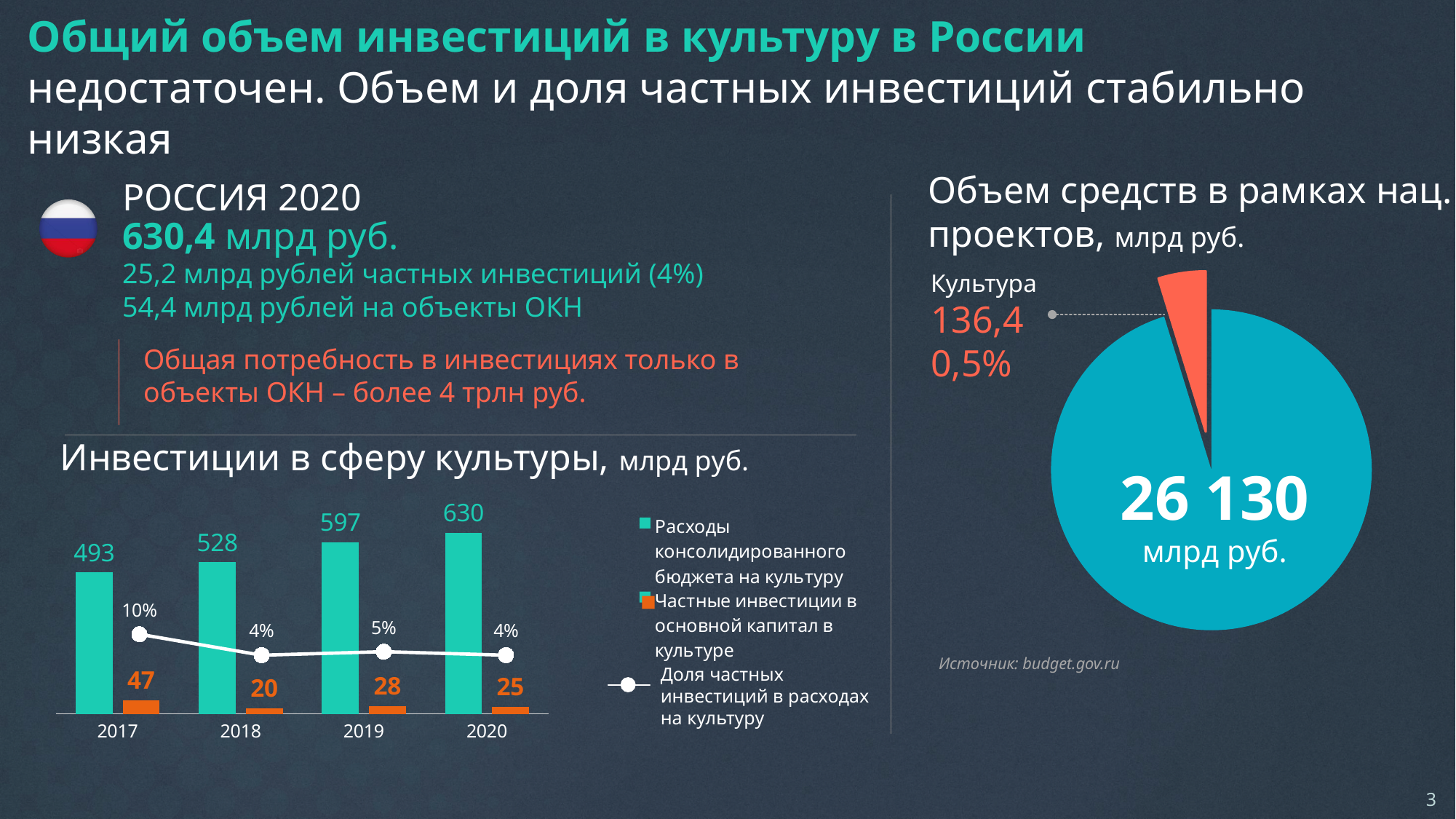
In the chart 'Инвестиции в сферу культуры, млрд руб.', which year has the highest value for 'Расходы консолидированного бюджета на культуру'? 2020 In the pie chart 'Объем средств в рамках нац. проектов, млрд руб.', what is the value shown for 'Культура'? 136,4 How many series does the legend of the chart 'Инвестиции в сферу культуры, млрд руб.' list? 3 In the chart 'Инвестиции в сферу культуры, млрд руб.', what is the 'Доля частных инвестиций в расходах на культуру' for 2017? 10% How many years are shown on the x axis of the chart 'Инвестиции в сферу культуры, млрд руб.'? 4 In the pie chart 'Объем средств в рамках нац. проектов, млрд руб.', what share does the 'Культура' slice represent? 0,5% In the chart 'Инвестиции в сферу культуры, млрд руб.', do the values for 'Расходы консолидированного бюджета на культуру' rise or fall from 2017 to 2020? rise In the chart 'Инвестиции в сферу культуры, млрд руб.', which year has the larger value for 'Частные инвестиции в основной капитал в культуре': 2019 or 2020? 2019 In the chart 'Инвестиции в сферу культуры, млрд руб.', what is the difference between the 'Расходы консолидированного бюджета на культуру' values for 2020 and 2017? 137 In the chart 'Инвестиции в сферу культуры, млрд руб.', which year has the lowest value for 'Частные инвестиции в основной капитал в культуре'? 2018 In the chart 'Инвестиции в сферу культуры, млрд руб.', what is the value of 'Расходы консолидированного бюджета на культуру' for 2019? 597 In the chart 'Инвестиции в сферу культуры, млрд руб.', what is the value of 'Частные инвестиции в основной капитал в культуре' for 2017? 47